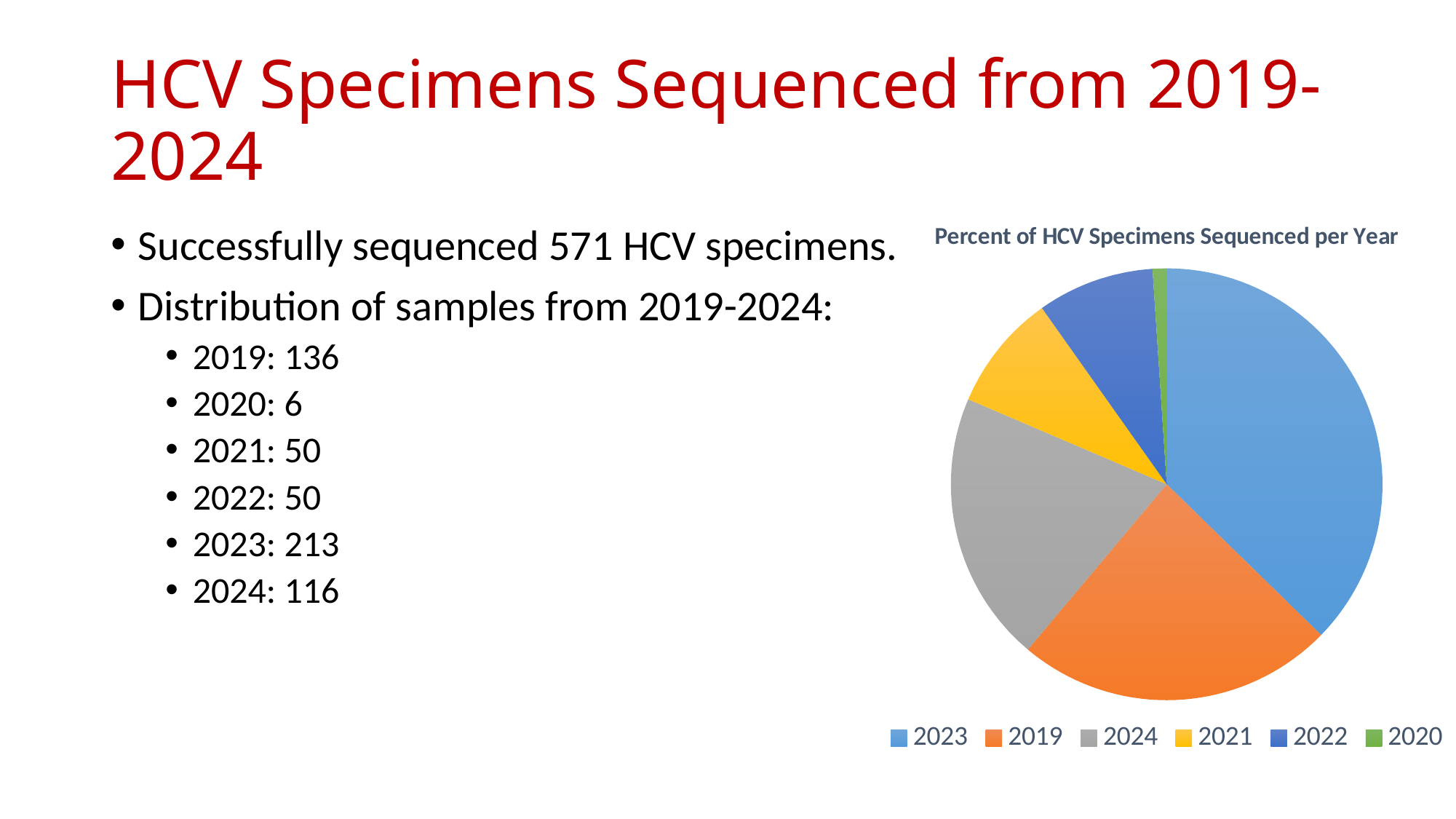
According to the slide, how many HCV specimens were sequenced in 2020? 6 Which year has the smallest slice of the pie chart? 2020 What kind of chart is shown on the slide? pie chart Which slice is larger in the pie chart, 2019 or 2024? 2019 How many entries does the chart legend list? 6 What is the difference between the number of specimens sequenced in 2023 and in 2019? 77 Which slice is larger in the pie chart, 2023 or 2021? 2023 Which colour represents 2024 in the pie chart? gray What is the title of the chart? Percent of HCV Specimens Sequenced per Year According to the slide, how many HCV specimens were sequenced in 2023? 213 Which year has the largest slice of the pie chart? 2023 How many slices does the pie chart have? 6